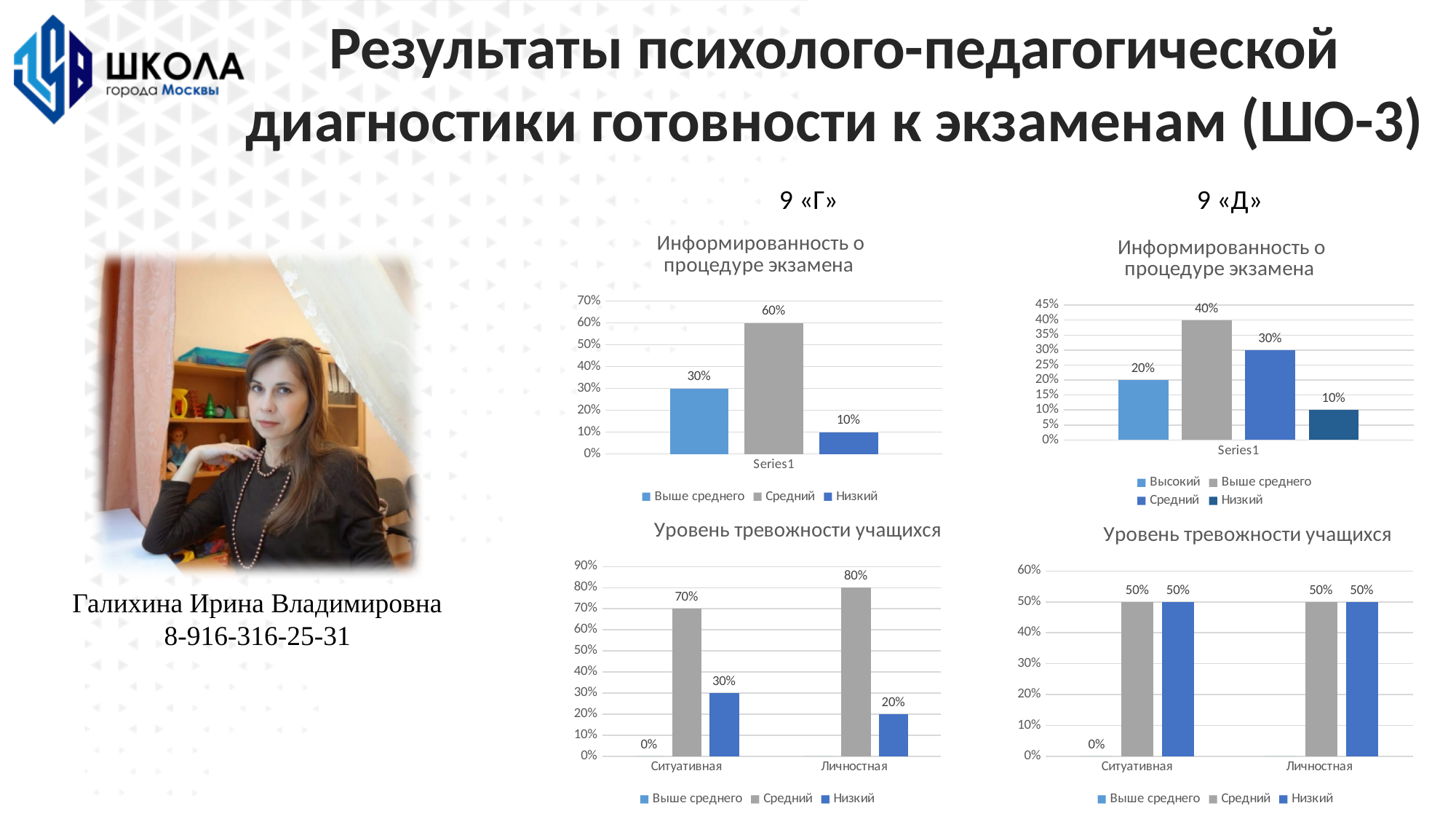
In the 9 «Г» chart 'Информированность о процедуре экзамена', which category has the lowest value? Низкий In the 9 «Г» chart 'Уровень тревожности учащихся', which is larger for Ситуативная: Средний or Низкий? Средний In the 9 «Д» chart 'Уровень тревожности учащихся', what is the value for Низкий in the Ситуативная category? 50% In the 9 «Г» chart 'Уровень тревожности учащихся', what is the difference between Низкий for Ситуативная and Низкий for Личностная? 10% In the 9 «Г» chart 'Уровень тревожности учащихся', what is the value for Средний in the Личностная category? 80% In the 9 «Д» chart 'Информированность о процедуре экзамена', which category has the highest value? Выше среднего How many series does the legend list in the 9 «Д» chart 'Информированность о процедуре экзамена'? 4 In the 9 «Г» chart 'Информированность о процедуре экзамена', what is the value for Средний? 60% What kind of chart is the 9 «Г» chart 'Уровень тревожности учащихся'? Bar chart In the 9 «Г» chart 'Информированность о процедуре экзамена', what is the difference between Средний and Выше среднего? 30% How many categories are shown on the x axis of the 9 «Д» chart 'Уровень тревожности учащихся'? 2 In the 9 «Д» chart 'Информированность о процедуре экзамена', what is the value for Высокий? 20%